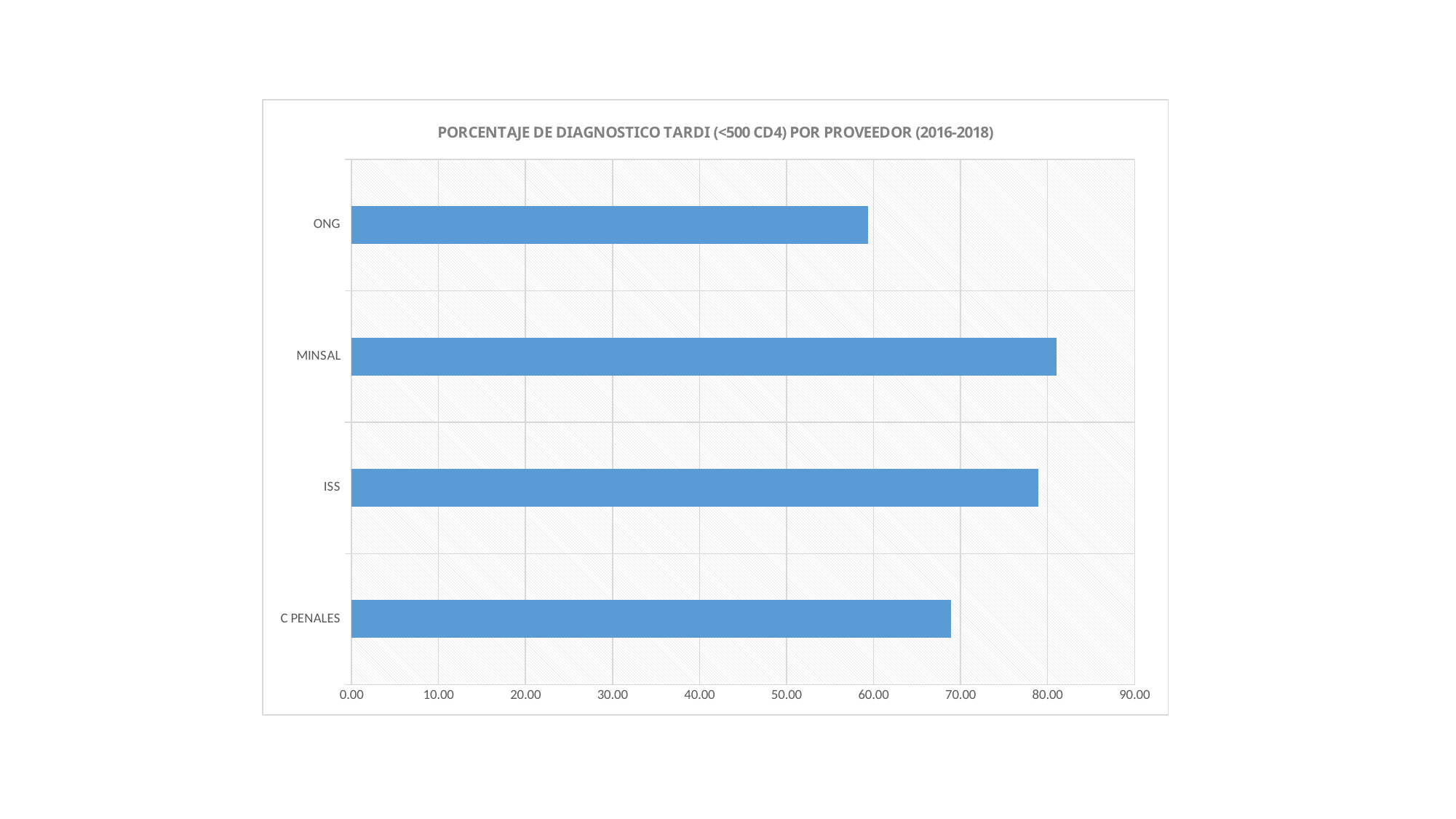
Is the value for ISS greater or less than 70.00? greater Which provider has the lowest percentage of late diagnosis? ONG Which has a higher value, ISS or ONG? ISS What kind of chart is shown on the slide? bar chart How many providers (categories) are plotted in the chart? 4 Is the value for ONG greater or less than 70.00? less Is the value for C PENALES greater or less than 60.00? greater What is the maximum value shown on the horizontal axis? 90.00 What is the title of the chart? PORCENTAJE DE DIAGNOSTICO TARDI (<500 CD4) POR PROVEEDOR (2016-2018) Which has a higher value, ONG or C PENALES? C PENALES